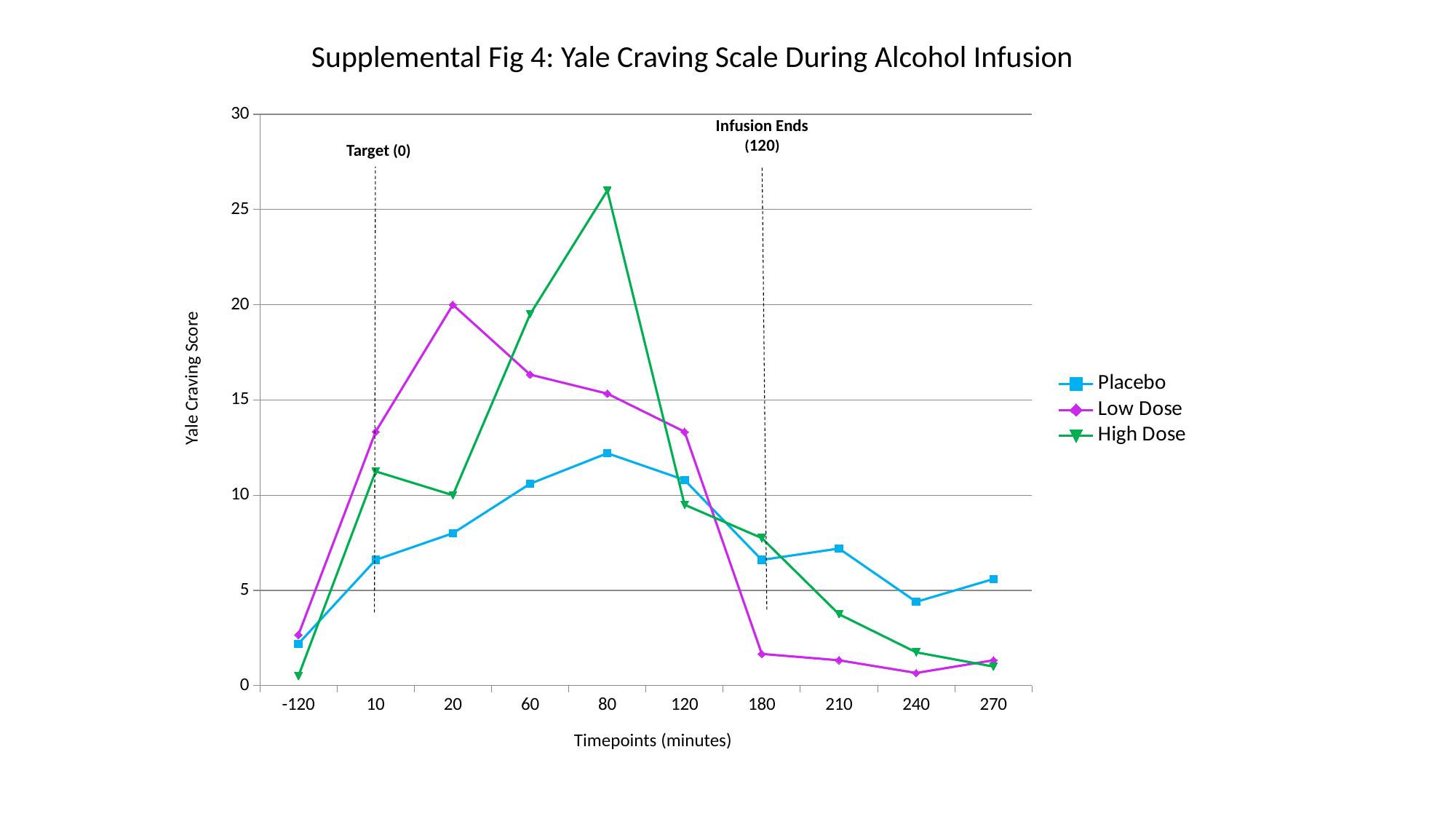
At 120 minutes, which is larger: the Low Dose value or the High Dose value? Low Dose Is the Placebo value at 80 minutes greater or less than 10? greater How many series does the legend list? 3 Which series has the highest Yale Craving Score at 80 minutes? High Dose Does the Low Dose series rise or fall between 20 minutes and 240 minutes? fall Is the Low Dose value at 180 minutes greater or less than 5? less How many timepoints are plotted along the x axis? 10 At 20 minutes, which is larger: the Low Dose value or the Placebo value? Low Dose At which timepoint does the Low Dose series reach its highest value? 20 Is the High Dose value at 80 minutes greater or less than 25? greater At which timepoint does the High Dose series reach its highest value? 80 What kind of chart is shown on the slide? line chart